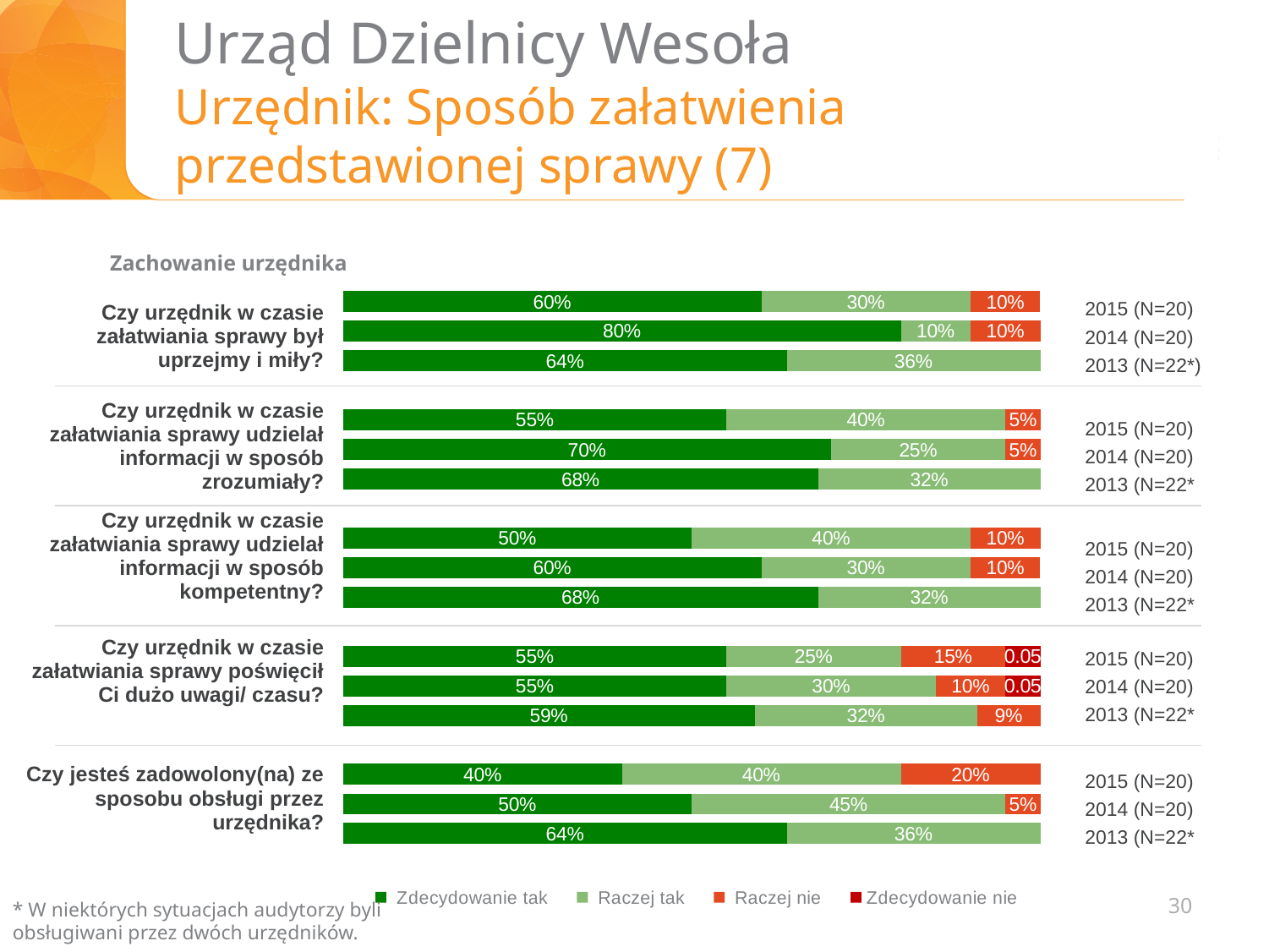
How many years (bars) are shown for each question in the chart? 3 For the question "Czy jesteś zadowolony(na) ze sposobu obsługi przez urzędnika?", which year has the lowest "Zdecydowanie tak" value? 2015 (N=20) For the question "Czy urzędnik w czasie załatwiania sprawy był uprzejmy i miły?", what is the "Zdecydowanie tak" value for 2014 (N=20)? 80% For the question "Czy jesteś zadowolony(na) ze sposobu obsługi przez urzędnika?", is the "Zdecydowanie tak" value larger in 2014 or in 2013? 2013 What kind of chart is shown on the slide? Stacked bar chart Which colour represents "Zdecydowanie tak" in the legend? Dark green For the question "Czy urzędnik w czasie załatwiania sprawy był uprzejmy i miły?", which year has the highest "Zdecydowanie tak" value? 2014 (N=20) For the question "Czy jesteś zadowolony(na) ze sposobu obsługi przez urzędnika?", what is the "Raczej nie" value for 2015 (N=20)? 20% For the question "Czy urzędnik w czasie załatwiania sprawy był uprzejmy i miły?", what is the difference between the "Zdecydowanie tak" values for 2014 and 2015? 20 percentage points How many series does the legend list? 4 For the question "Czy urzędnik w czasie załatwiania sprawy udzielał informacji w sposób zrozumiały?", what is the "Raczej tak" value for 2015 (N=20)? 40% For the question "Czy urzędnik w czasie załatwiania sprawy poświęcił Ci dużo uwagi/ czasu?", what is the "Raczej nie" value for 2013 (N=22*)? 9%